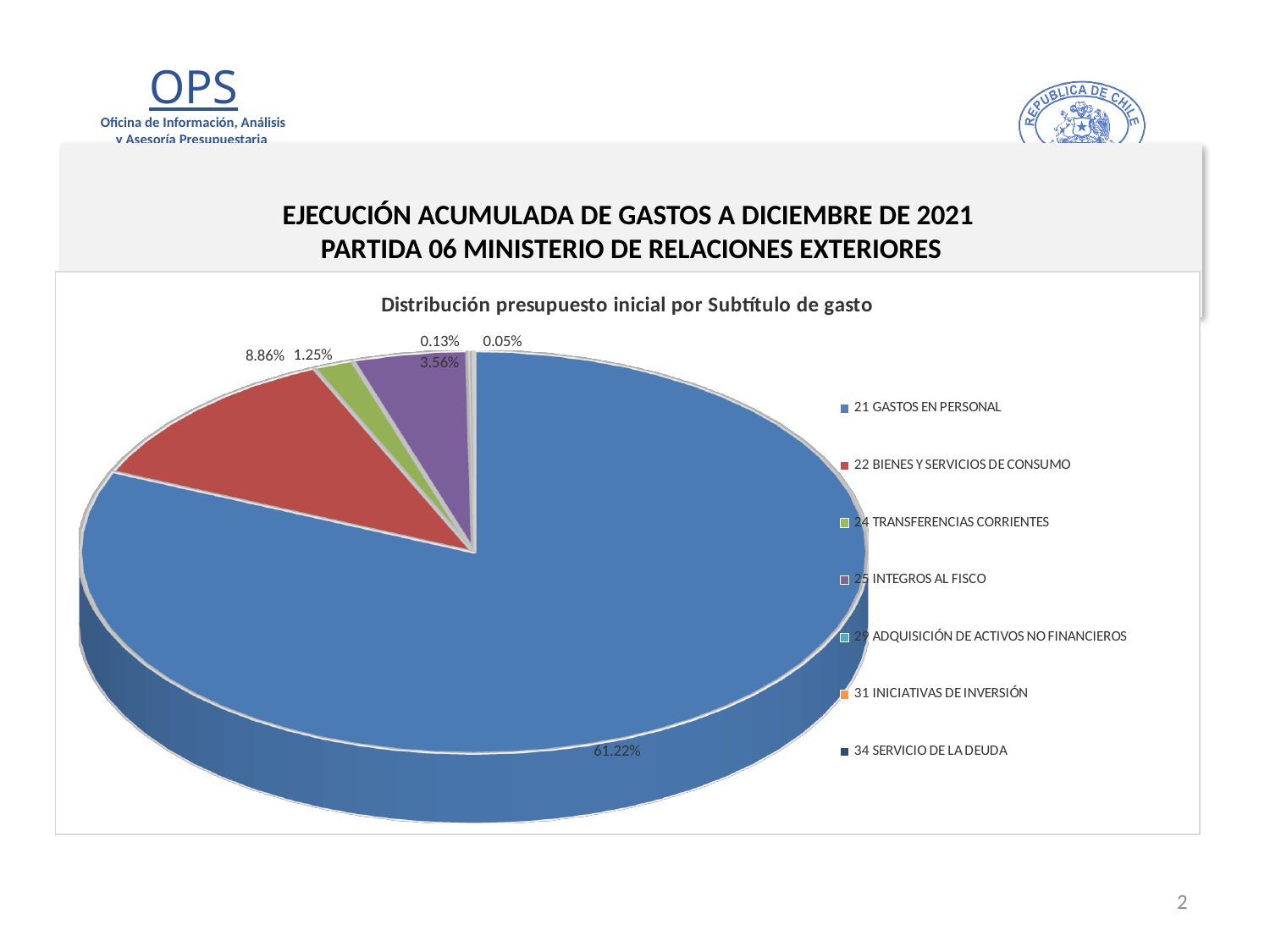
What kind of chart is shown on the slide? Pie chart What percentage is shown for 24 TRANSFERENCIAS CORRIENTES? 1.25% What is the title of the chart? Distribución presupuesto inicial por Subtítulo de gasto What colour is the slice for 21 GASTOS EN PERSONAL? Blue What percentage is shown for 21 GASTOS EN PERSONAL? 61.22% Which is larger, the share for 22 BIENES Y SERVICIOS DE CONSUMO or for 25 INTEGROS AL FISCO? 22 BIENES Y SERVICIOS DE CONSUMO What percentage is shown for 22 BIENES Y SERVICIOS DE CONSUMO? 8.86% What percentage is shown for 25 INTEGROS AL FISCO? 3.56% What is the smallest percentage label printed on the chart? 0.05% Which category has the largest share of the pie? 21 GASTOS EN PERSONAL What is the difference in percentage points between 22 BIENES Y SERVICIOS DE CONSUMO and 24 TRANSFERENCIAS CORRIENTES? 7.61 How many categories does the chart legend list? 7